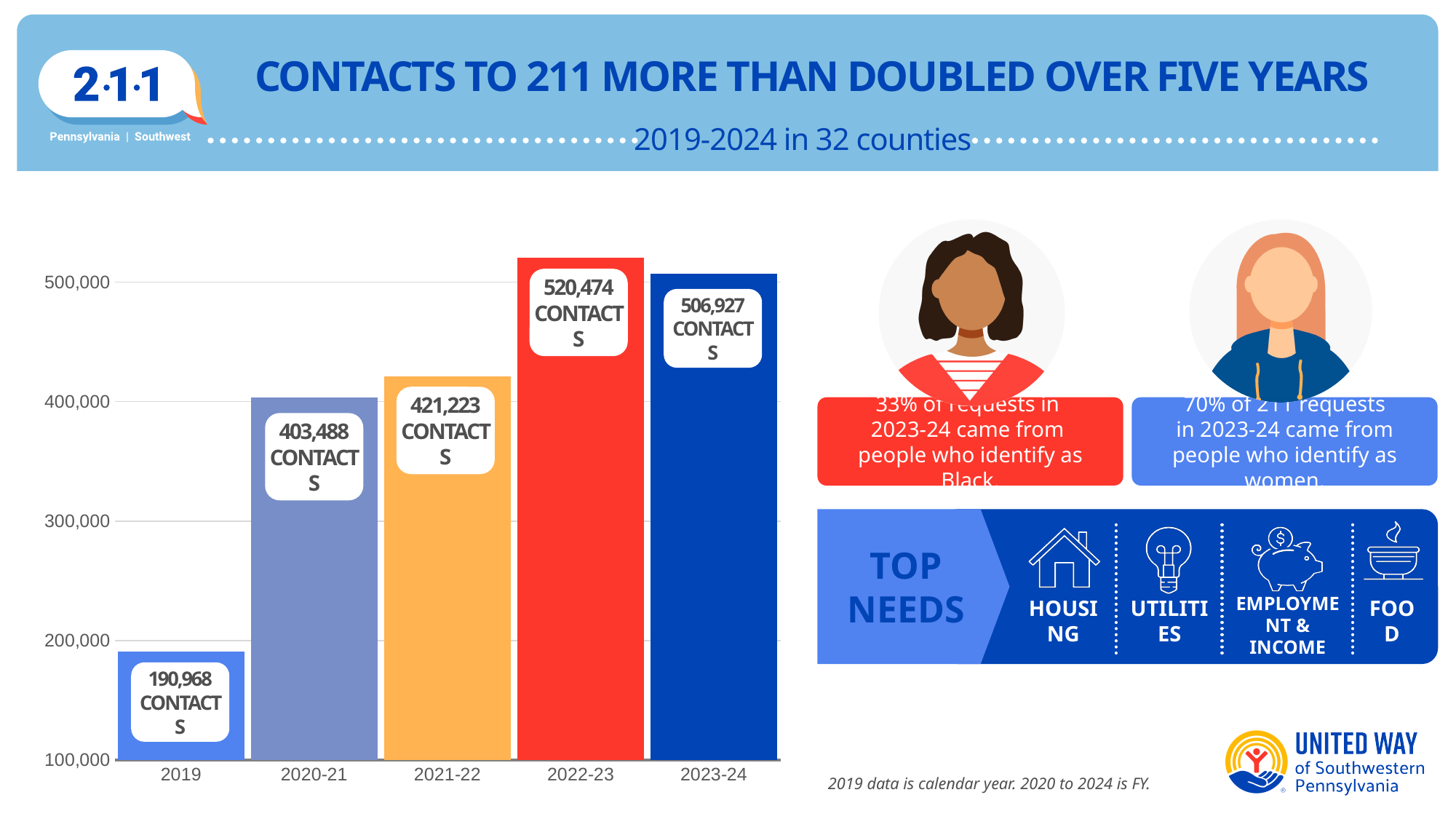
What is the difference in contacts between 2022-23 and 2023-24? 13,547 Which period had the lowest number of contacts? 2019 What kind of chart is shown on the slide? bar chart Which period had the highest number of contacts? 2022-23 How many contacts to 211 were there in 2019? 190,968 How many contacts to 211 were there in 2022-23? 520,474 How many periods are shown on the x axis of the chart? 5 Is the value for 2021-22 greater or less than 400,000? greater Do the contact numbers rise or fall from 2019 to 2022-23? rise What is the difference in contacts between 2020-21 and 2019? 212,520 How many contacts to 211 were there in 2023-24? 506,927 Which had more contacts, 2021-22 or 2020-21? 2021-22